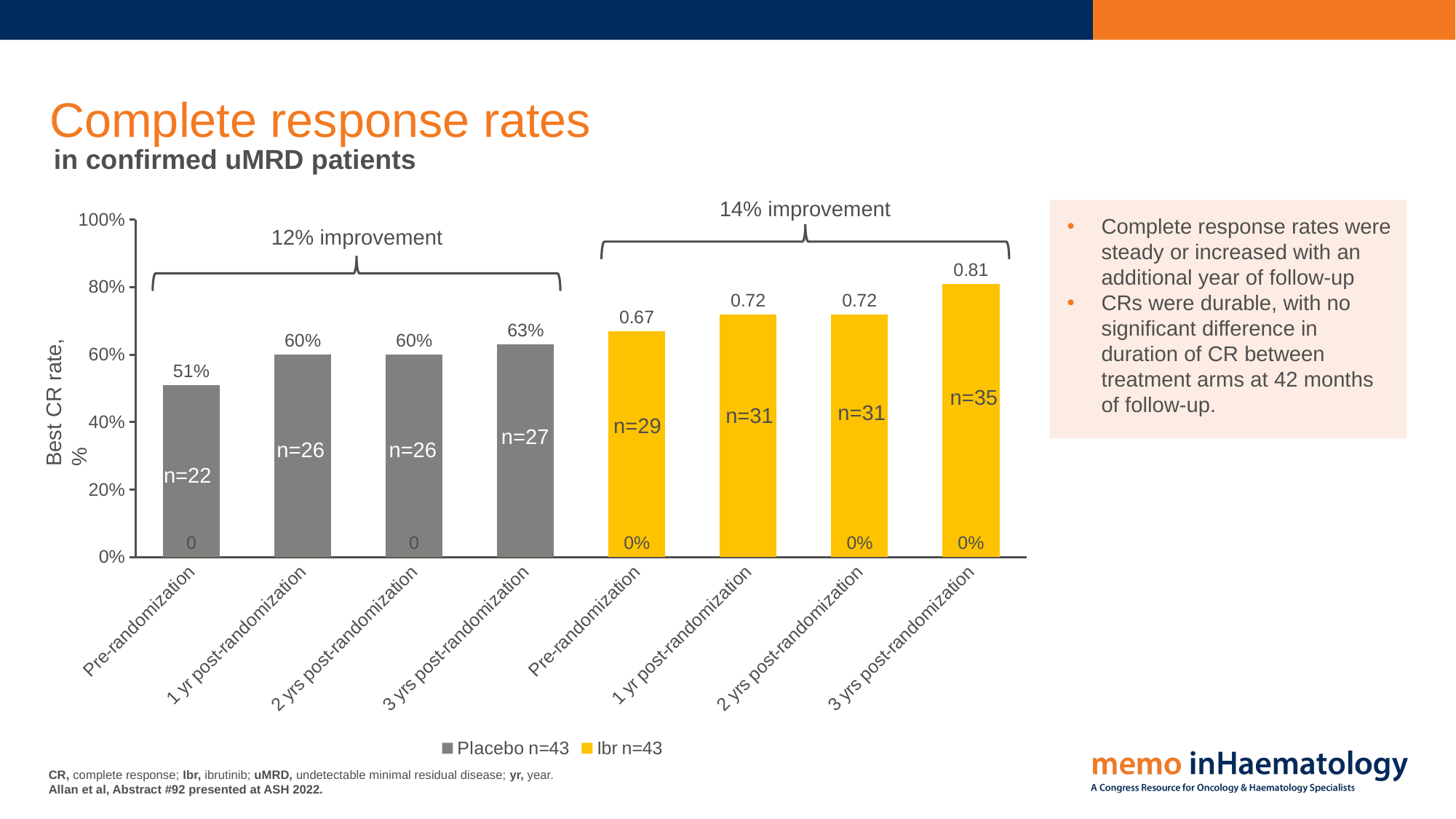
How many series does the legend list? 2 What is the best CR rate for the Ibr arm at 3 yrs post-randomization? 0.81 What is the difference between the Placebo best CR rate at 3 yrs post-randomization and at pre-randomization? 12% What is the best CR rate for the Placebo arm at 3 yrs post-randomization? 63% Which is larger: the Ibr best CR rate at 1 yr post-randomization or the Placebo best CR rate at 1 yr post-randomization? Ibr What is the best CR rate for the Ibr arm at pre-randomization? 0.67 How many bars are plotted in the chart? 8 What is the best CR rate for the Placebo arm at pre-randomization? 51% Which bar has the lowest best CR rate? Placebo, pre-randomization What kind of chart is shown on the slide? Bar chart Which bar has the highest best CR rate? Ibr, 3 yrs post-randomization Do the Ibr best CR rates rise or fall from pre-randomization to 3 yrs post-randomization? Rise